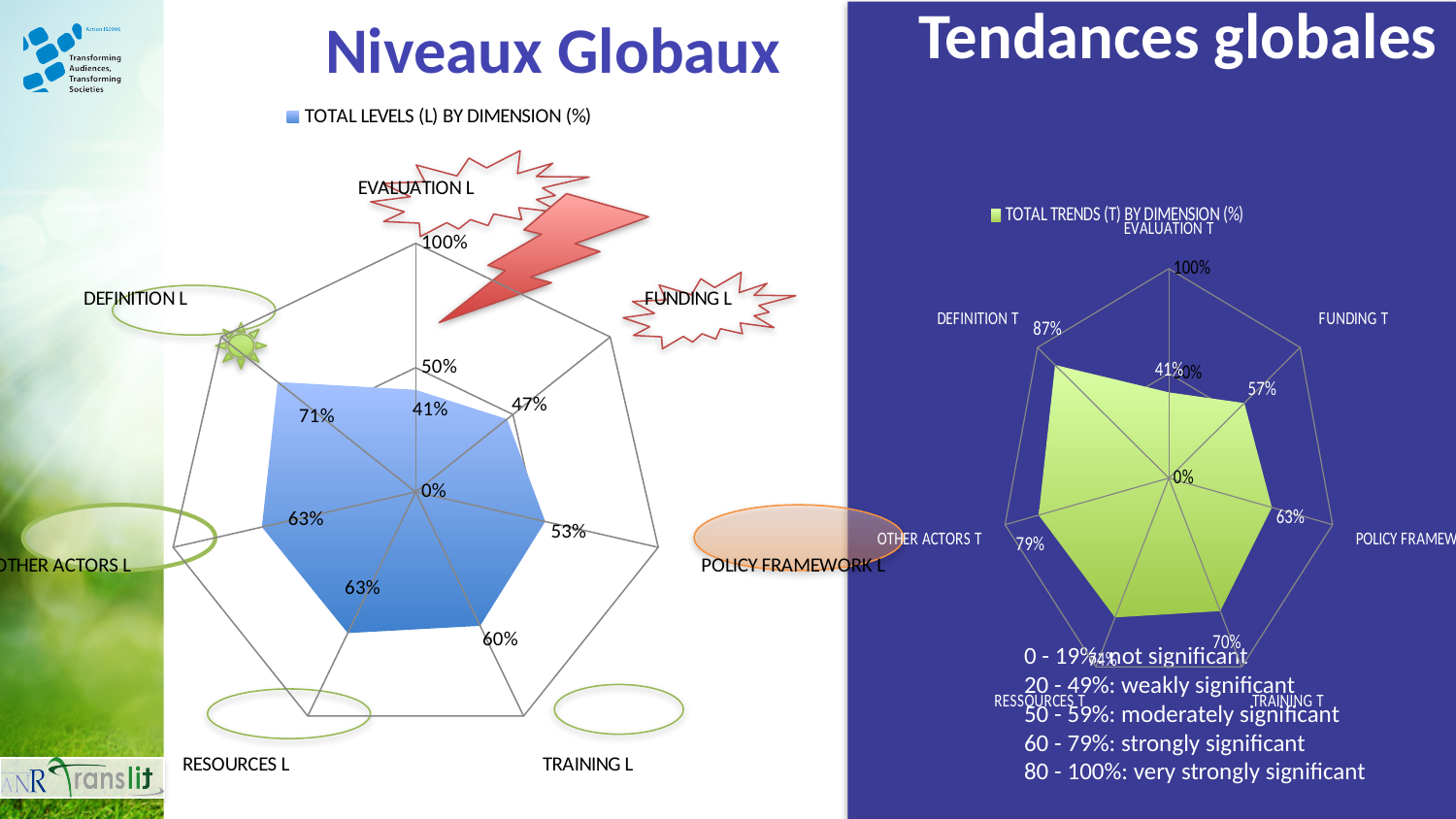
In the left chart 'TOTAL LEVELS (L) BY DIMENSION (%)', how many dimensions are plotted? 7 In the right chart 'TOTAL TRENDS (T) BY DIMENSION (%)', which is larger: FUNDING T or POLICY FRAMEWORK T? POLICY FRAMEWORK T In the left chart 'TOTAL LEVELS (L) BY DIMENSION (%)', what is the value for TRAINING L? 60% In the right chart 'TOTAL TRENDS (T) BY DIMENSION (%)', what is the value for OTHER ACTORS T? 79% In the right chart 'TOTAL TRENDS (T) BY DIMENSION (%)', which dimension has the highest value? DEFINITION T In the left chart 'TOTAL LEVELS (L) BY DIMENSION (%)', which dimension has the highest value? DEFINITION L In the left chart 'TOTAL LEVELS (L) BY DIMENSION (%)', what is the difference between DEFINITION L and FUNDING L? 24% In the left chart 'TOTAL LEVELS (L) BY DIMENSION (%)', which dimension has the lowest value? EVALUATION L How many series does the legend of the right chart 'TOTAL TRENDS (T) BY DIMENSION (%)' list? 1 In the left chart 'TOTAL LEVELS (L) BY DIMENSION (%)', what is the value for DEFINITION L? 71% In the right chart 'TOTAL TRENDS (T) BY DIMENSION (%)', what is the value for DEFINITION T? 87% What type of chart is the 'TOTAL LEVELS (L) BY DIMENSION (%)' chart on the left? Radar chart